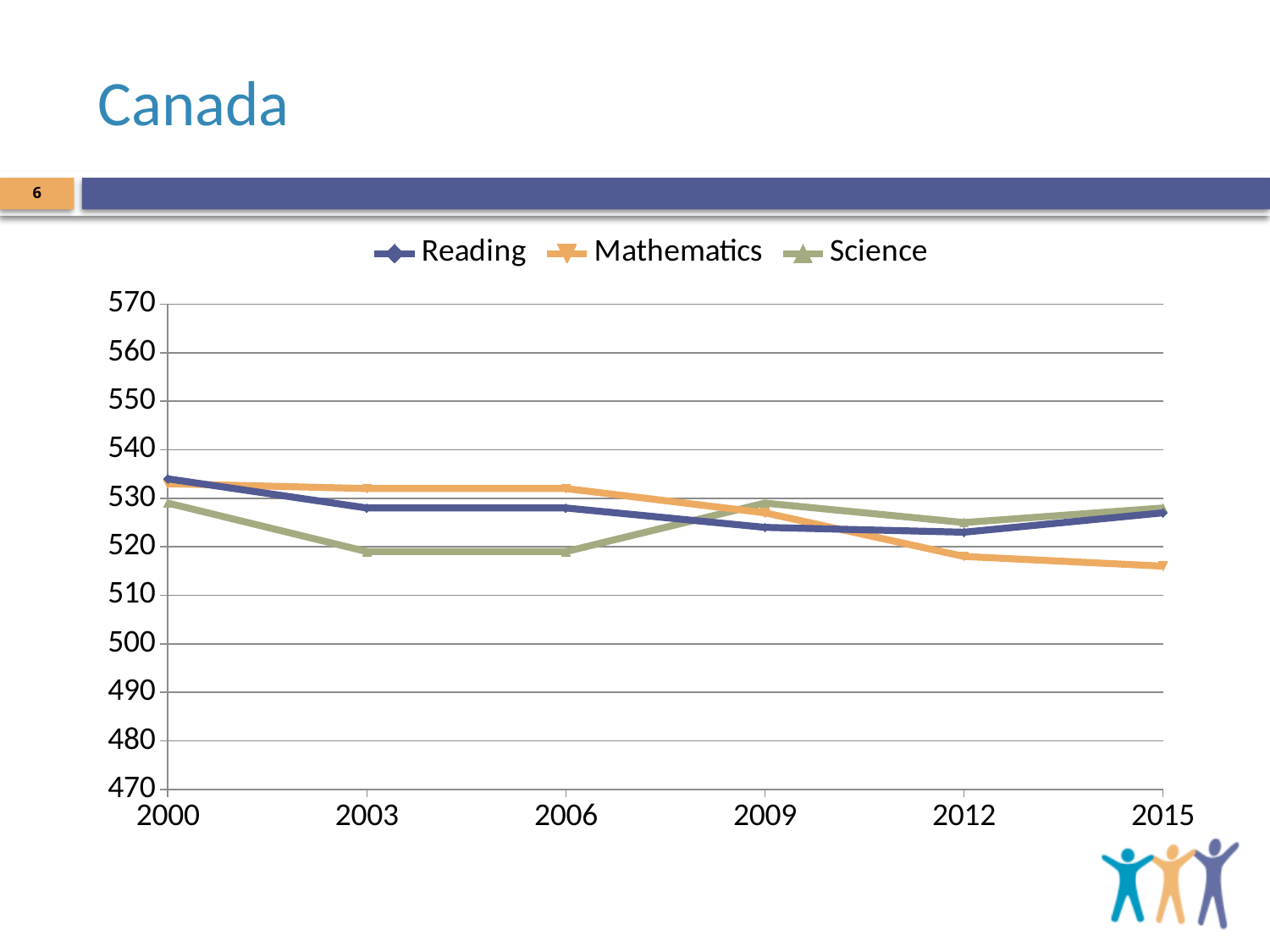
In 2015, which is higher, Reading or Mathematics? Reading Does the Mathematics line rise or fall from 2000 to 2015? fall How many series does the legend list? 3 Is the value for Reading in 2000 greater or less than 530? greater Is the value for Reading in 2009 greater or less than 530? less Which series does the legend list first? Reading What kind of chart is shown on the slide? line chart Is the value for Mathematics in 2000 greater or less than 530? greater In 2003, which is higher, Mathematics or Science? Mathematics Which series has the lowest value in 2015? Mathematics How many years are plotted along the x axis? 6